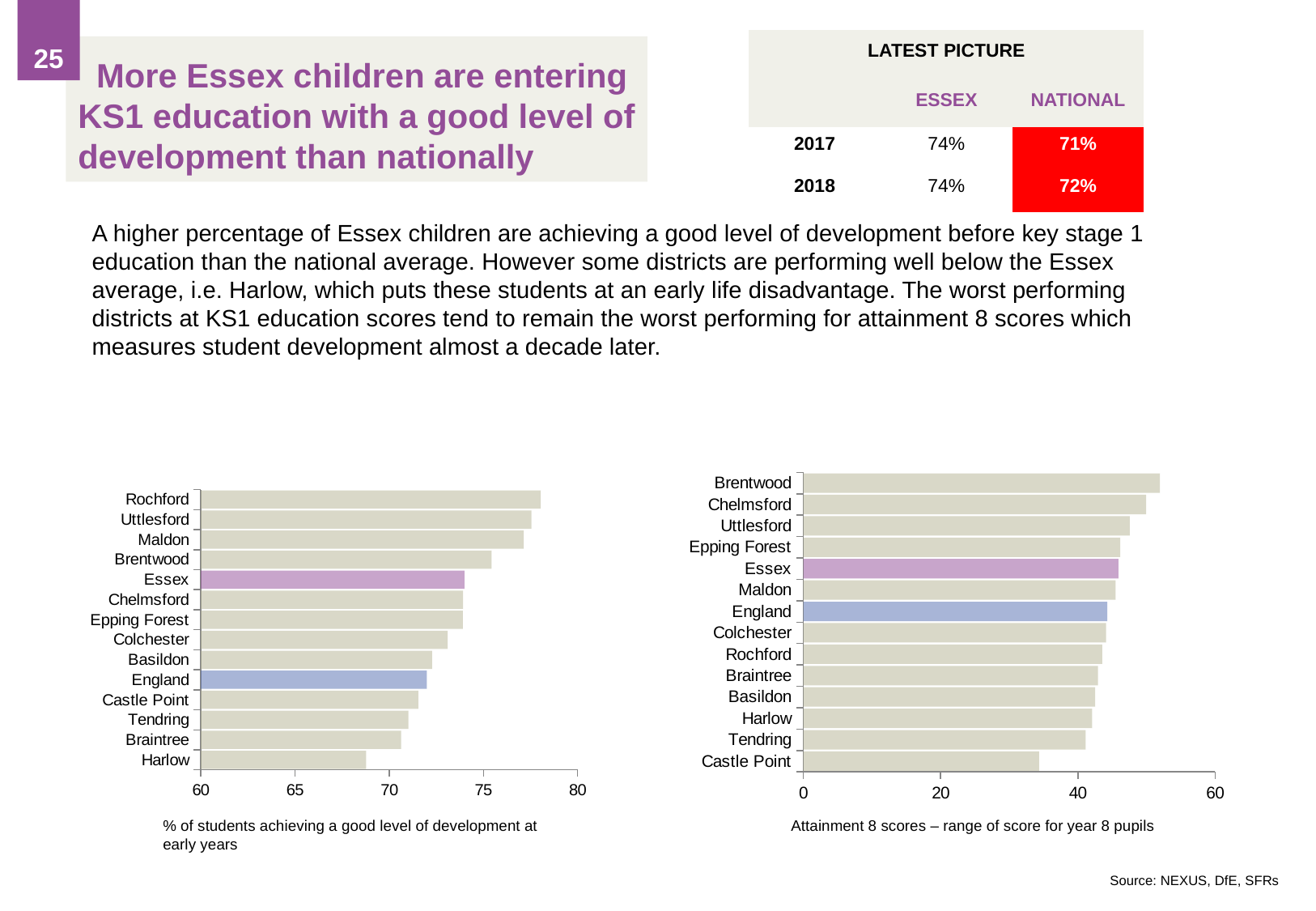
In the right chart (Attainment 8 scores), which area has the highest score? Brentwood In the right chart (Attainment 8 scores), which has the larger value, Chelmsford or Harlow? Chelmsford In the right chart (Attainment 8 scores), what colour is the bar for England? blue In the right chart (Attainment 8 scores), is the value for Castle Point greater or less than 40? less In the left chart (% of students achieving a good level of development at early years), is the value for Rochford greater or less than 75? greater What kind of chart is the left chart showing % of students achieving a good level of development at early years? bar chart In the left chart (% of students achieving a good level of development at early years), which area has the lowest value? Harlow In the left chart (% of students achieving a good level of development at early years), is the value for Harlow greater or less than 70? less In the left chart (% of students achieving a good level of development at early years), which has the larger value, Essex or England? Essex How many areas are plotted in the left chart (% of students achieving a good level of development at early years)? 14 In the right chart (Attainment 8 scores), which area has the lowest score? Castle Point In the left chart (% of students achieving a good level of development at early years), which area has the highest value? Rochford